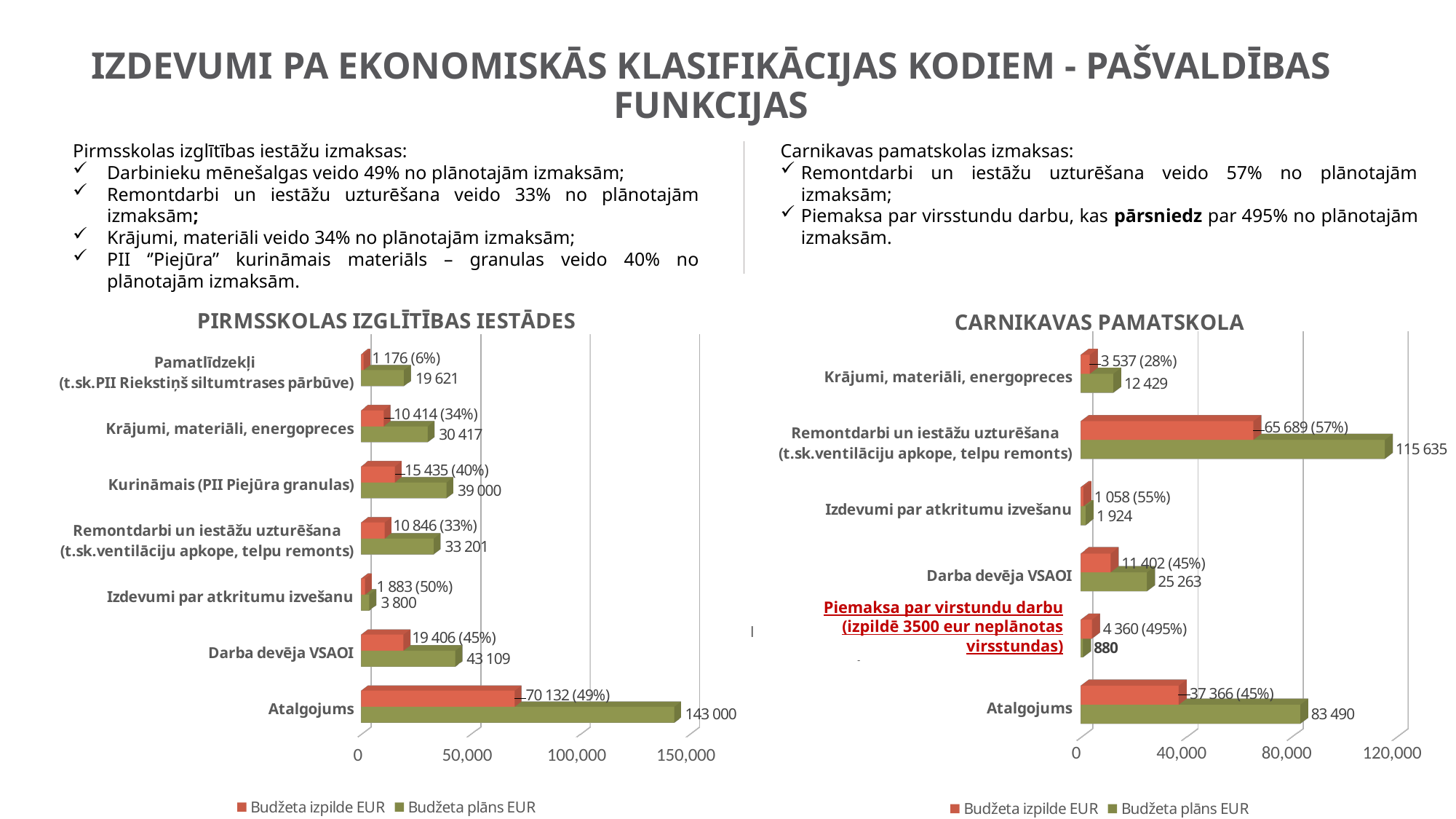
What type of chart is the PIRMSSKOLAS IZGLĪTĪBAS IESTĀDES chart? bar chart In the CARNIKAVAS PAMATSKOLA chart, is the Budžeta plāns EUR value for Atalgojums greater or less than 80,000? greater In the CARNIKAVAS PAMATSKOLA chart, what is the Budžeta izpilde EUR value for Piemaksa par virstundu darbu? 4 360 In the CARNIKAVAS PAMATSKOLA chart, which category has the highest Budžeta izpilde EUR value? Remontdarbi un iestāžu uzturēšana In the PIRMSSKOLAS IZGLĪTĪBAS IESTĀDES chart, what is the Budžeta plāns EUR value for Atalgojums? 143 000 In the CARNIKAVAS PAMATSKOLA chart, what is the Budžeta plāns EUR value for Remontdarbi un iestāžu uzturēšana? 115 635 How many series does the legend of the CARNIKAVAS PAMATSKOLA chart list? 2 In the CARNIKAVAS PAMATSKOLA chart, is the Budžeta izpilde EUR value for Atalgojums larger or smaller than the Budžeta plāns EUR value for Darba devēja VSAOI? larger In the PIRMSSKOLAS IZGLĪTĪBAS IESTĀDES chart, what is the difference between the Budžeta plāns EUR and Budžeta izpilde EUR values for Darba devēja VSAOI? 23 703 In the PIRMSSKOLAS IZGLĪTĪBAS IESTĀDES chart, what is the Budžeta izpilde EUR value for Kurināmais (PII Piejūra granulas)? 15 435 In the PIRMSSKOLAS IZGLĪTĪBAS IESTĀDES chart, which category has the lowest Budžeta plāns EUR value? Izdevumi par atkritumu izvešanu In the PIRMSSKOLAS IZGLĪTĪBAS IESTĀDES chart, how many categories are shown? 7